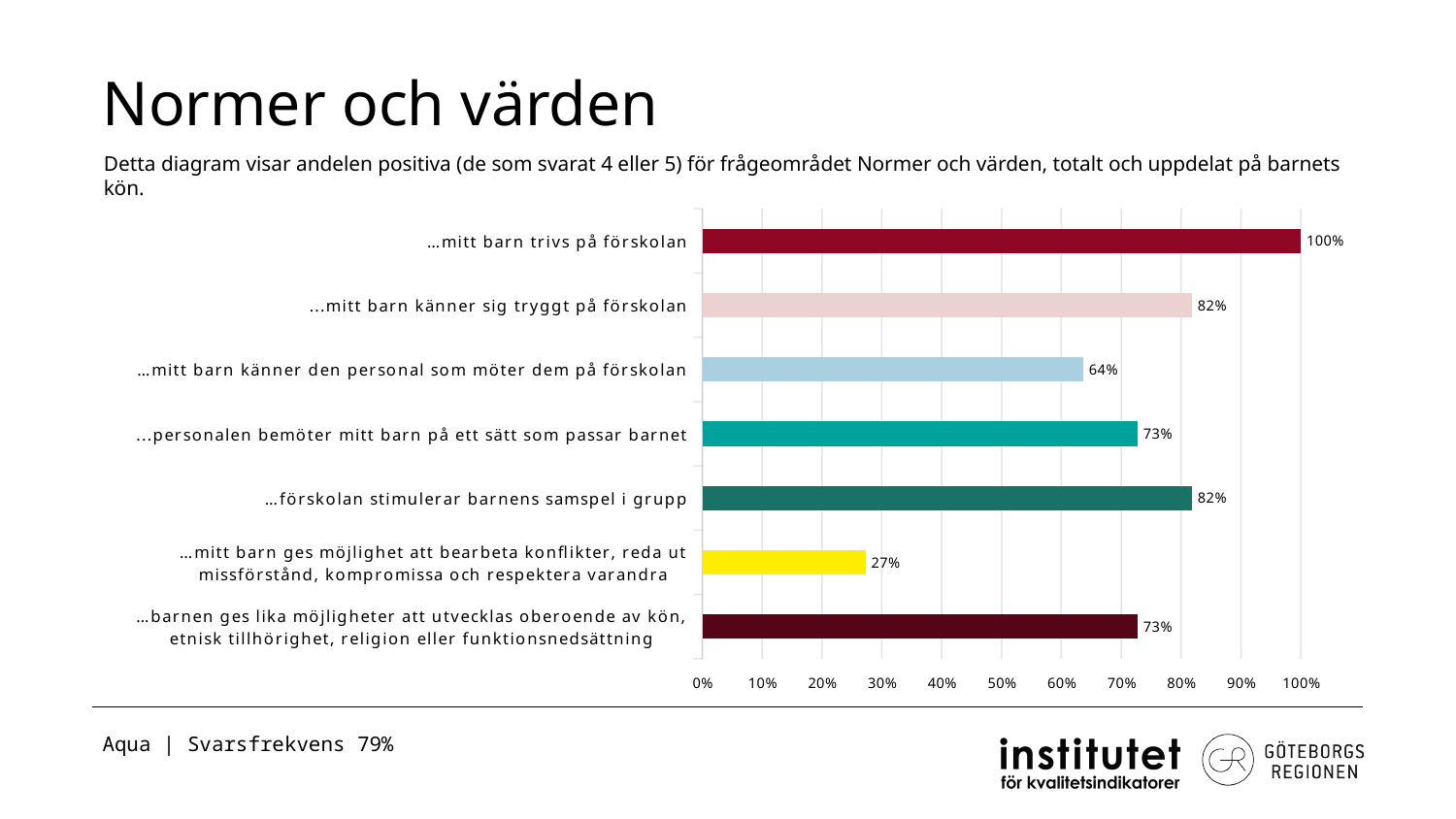
Which is larger: the value for "…mitt barn känner den personal som möter dem på förskolan" or the value for "...personalen bemöter mitt barn på ett sätt som passar barnet"? ...personalen bemöter mitt barn på ett sätt som passar barnet What kind of chart is shown on the slide? bar chart What is the value for "…förskolan stimulerar barnens samspel i grupp"? 82% What is the title of the slide containing the chart? Normer och värden How many categories are shown in the chart? 7 What is the difference between the value for "…mitt barn trivs på förskolan" and the value for "…mitt barn ges möjlighet att bearbeta konflikter, reda ut missförstånd, kompromissa och respektera varandra"? 73 percentage points Is the value for "…mitt barn känner den personal som möter dem på förskolan" greater or less than 60%? greater What is the value for "…mitt barn känner den personal som möter dem på förskolan"? 64% Which category has the highest value? …mitt barn trivs på förskolan What is the value for "…mitt barn trivs på förskolan"? 100% What is the value for "…mitt barn ges möjlighet att bearbeta konflikter, reda ut missförstånd, kompromissa och respektera varandra"? 27% Which category has the lowest value? …mitt barn ges möjlighet att bearbeta konflikter, reda ut missförstånd, kompromissa och respektera varandra